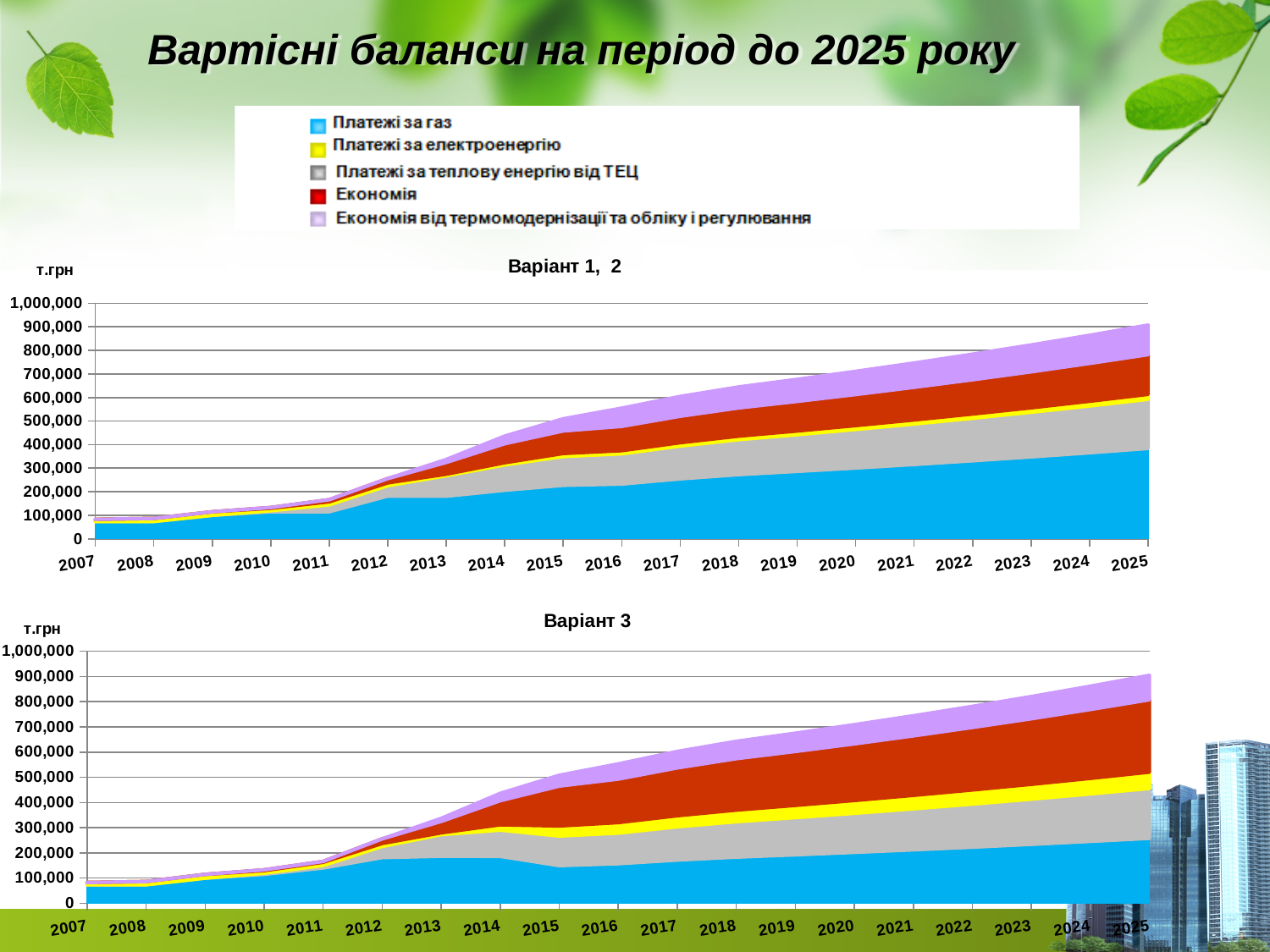
In the "Варіант 3" chart, is the value for Платежі за газ in 2025 greater or less than 300,000? less In the "Варіант 1, 2" chart, does the total stacked value rise or fall from 2007 to 2025? rise In the "Варіант 3" chart, is the total stacked value in 2012 greater or less than 200,000? greater In the "Варіант 1, 2" chart, is the value for Платежі за газ in 2025 greater or less than 300,000? greater Which chart shows a larger value for Платежі за газ in 2025, "Варіант 1, 2" or "Варіант 3"? Варіант 1, 2 What is the title of the slide? Вартісні баланси на період до 2025 року How many series does the legend list for the charts? 5 How many years are shown on the x axis of the "Варіант 3" chart? 19 What kind of chart is the "Варіант 1, 2" chart? stacked area chart Which series is shown in blue in the legend? Платежі за газ